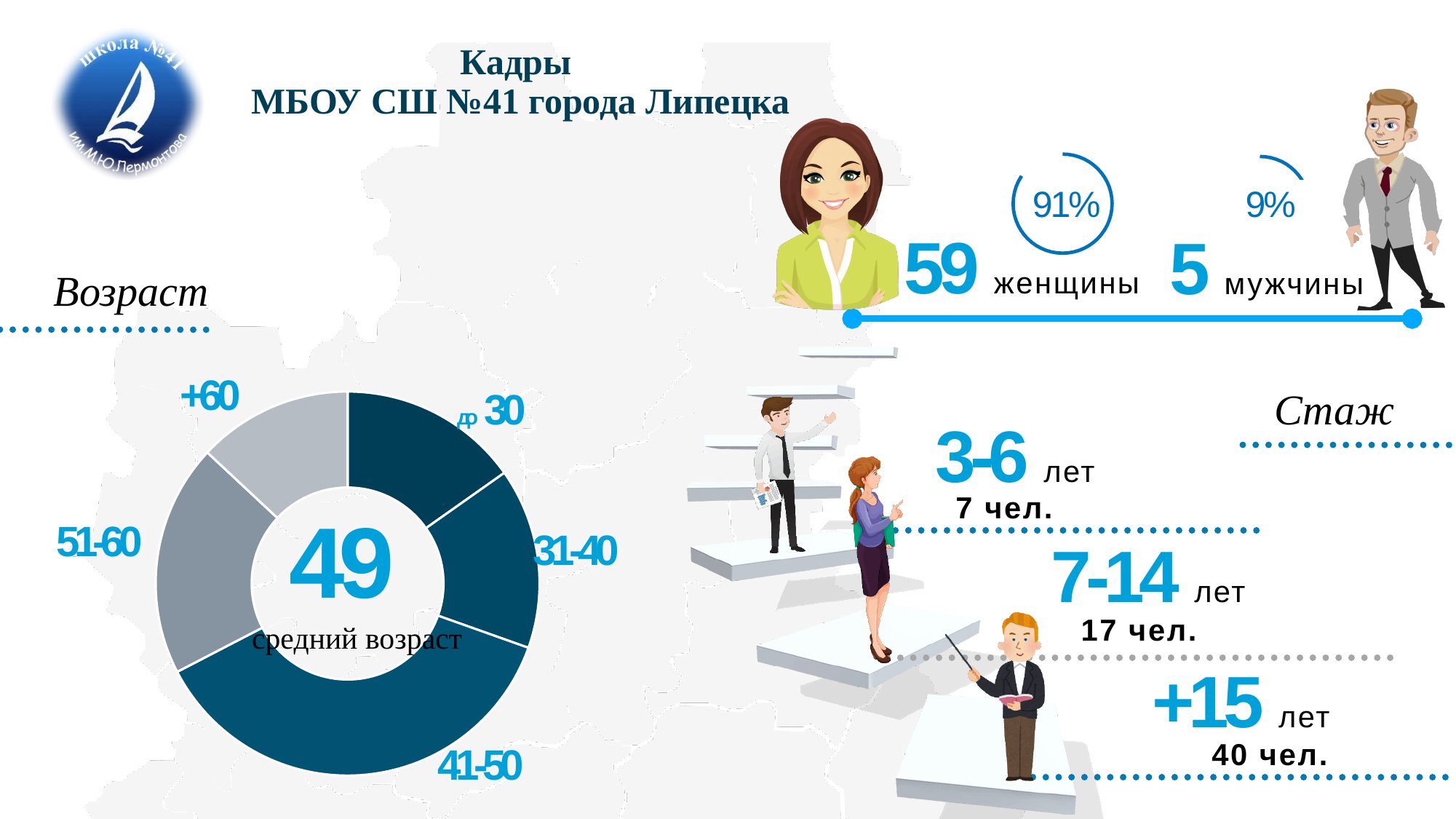
What does the number in the centre of the "Возраст" donut chart represent, according to the label? средний возраст In the "Возраст" donut chart, which slice is larger: 41-50 or 51-60? 41-50 What is the title of the donut chart on the left of the slide? Возраст In the gender ring gauges at the top right, what percentage is shown for мужчины? 9% Which age category has the largest slice in the "Возраст" donut chart? 41-50 In the "Возраст" donut chart, which slice is larger: 51-60 or 31-40? 51-60 In the gender ring gauges at the top right, what is the difference between the percentage for женщины and the percentage for мужчины? 82% In the gender ring gauges at the top right, what percentage is shown for женщины? 91% What number is printed in the centre of the "Возраст" donut chart? 49 In the "Стаж" section, which experience group has the most people? +15 лет How many age categories does the "Возраст" donut chart show? 5 What kind of chart is the "Возраст" chart on the left of the slide? Donut (pie) chart